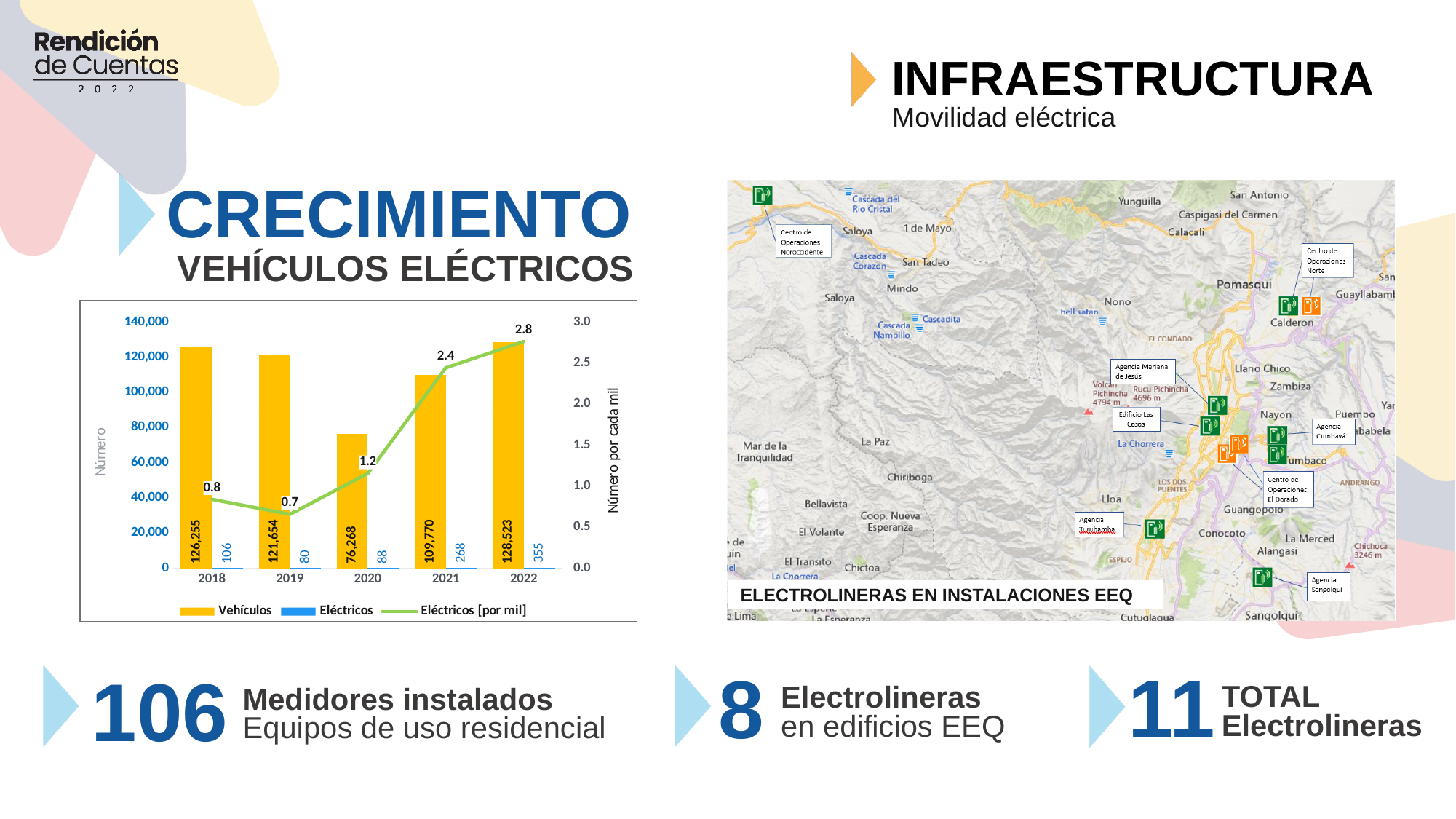
What is the difference between the Eléctricos values for 2022 and 2021? 87 How many years are shown on the x axis of the chart? 5 Does the Eléctricos [por mil] line rise or fall from 2019 to 2022? rise What is the value of Eléctricos for 2022? 355 What is the label of the right-hand vertical axis of the chart? Número por cada mil Which year has the lowest value for Eléctricos? 2019 Which year has the highest value for Vehículos? 2022 Which is larger, the Vehículos value for 2018 or for 2019? 2018 What is the value of Vehículos for 2020? 76,268 What is the difference between the Vehículos values for 2022 and 2020? 52,255 What is the value of Eléctricos [por mil] for 2021? 2.4 How many series does the chart legend list? 3